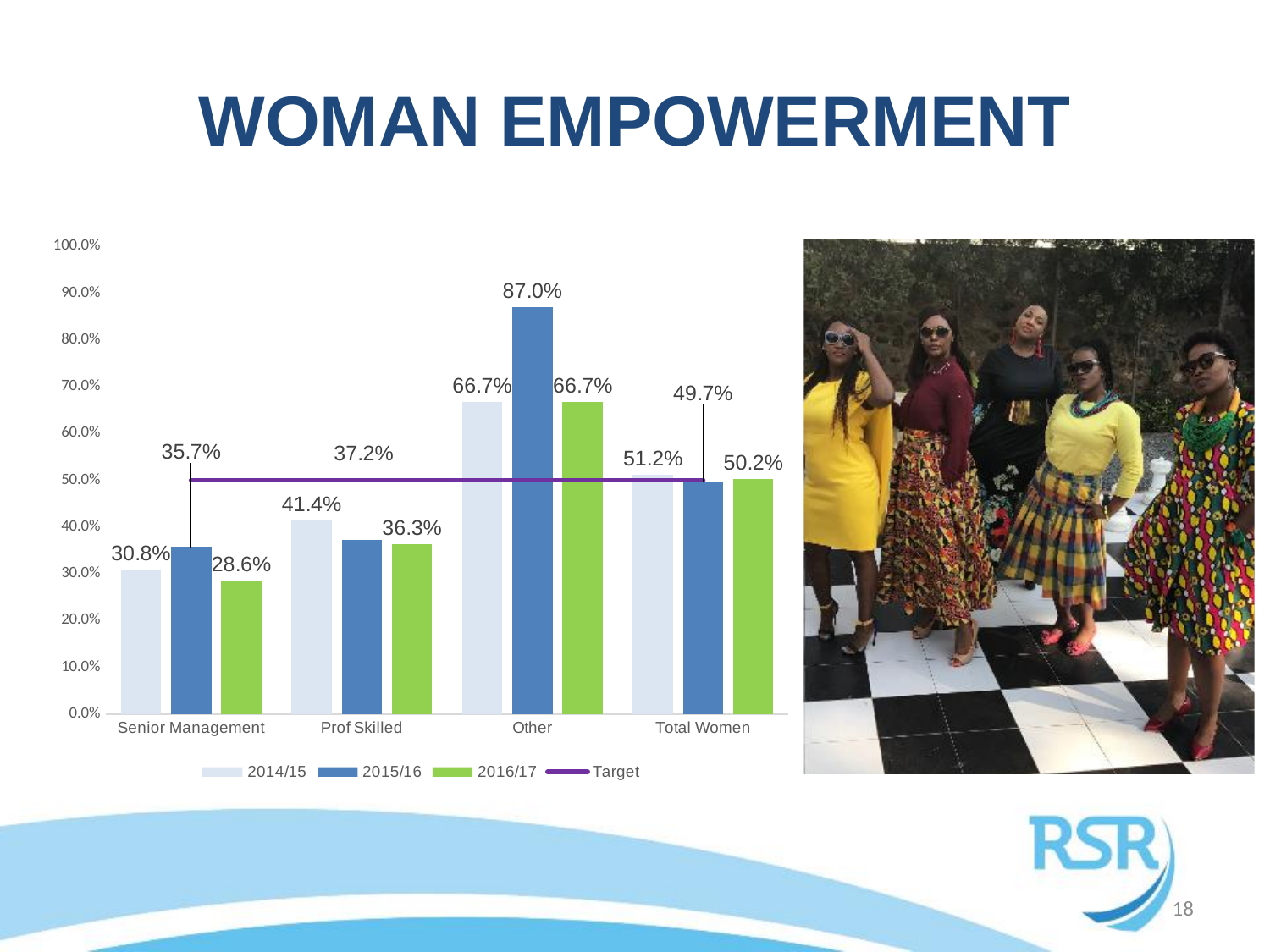
Which category has the highest 2015/16 value? Other Which category has the lowest 2016/17 value? Senior Management What is the 2015/16 value for Other? 87.0% Which is larger for Prof Skilled, the 2014/15 value or the 2015/16 value? 2014/15 What is the difference between the 2015/16 and 2014/15 values for Other? 20.3% What is the 2014/15 value for Prof Skilled? 41.4% What is the 2016/17 value for Senior Management? 28.6% What kind of chart is shown on the slide? Combination bar and line chart Is the 2014/15 value for Total Women greater or less than 50.0%? greater How many entries does the legend list? 4 How many categories are shown on the x axis? 4 What is the 2015/16 value for Total Women? 49.7%